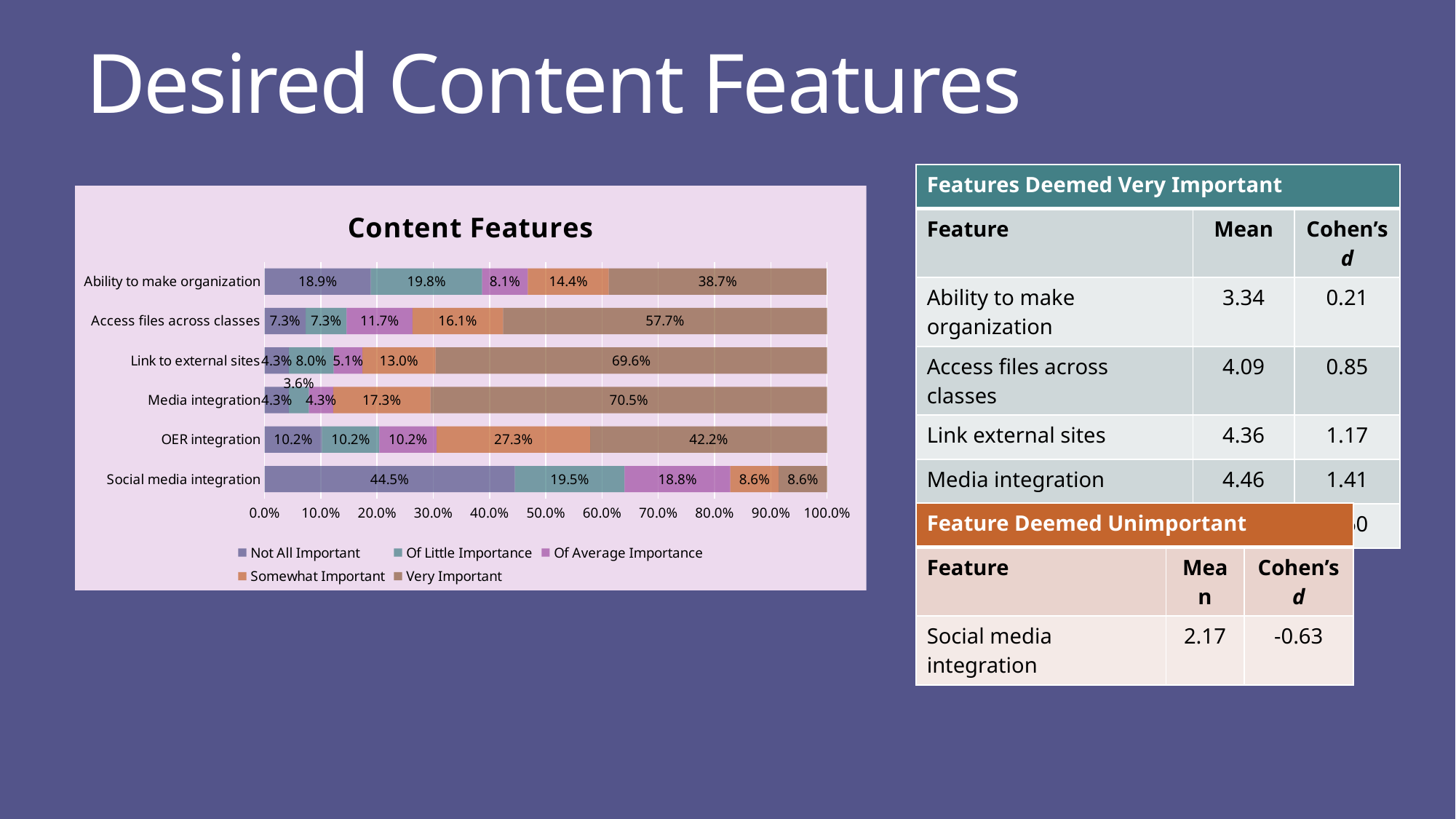
In the Content Features chart, which feature has the lowest Very Important percentage? Social media integration How many features are listed in the Content Features chart? 6 In the Content Features chart, what is the Of Average Importance value for Access files across classes? 11.7% In the Content Features chart, which feature has the highest Not All Important percentage? Social media integration How many series does the legend of the Content Features chart list? 5 In the Content Features chart, how many percentage points higher is the Not All Important value for Social media integration than for Ability to make organization? 25.6 percentage points In the Content Features chart, what is the Not All Important value for Social media integration? 44.5% In the Content Features chart, which has a larger Very Important share: Access files across classes or OER integration? Access files across classes What type of chart is the Content Features chart? Stacked bar chart In the Content Features chart, what percentage of respondents rated Media integration as Very Important? 70.5% In the Content Features chart, what is the Somewhat Important value for OER integration? 27.3% In the Content Features chart, which feature has the highest Very Important percentage? Media integration